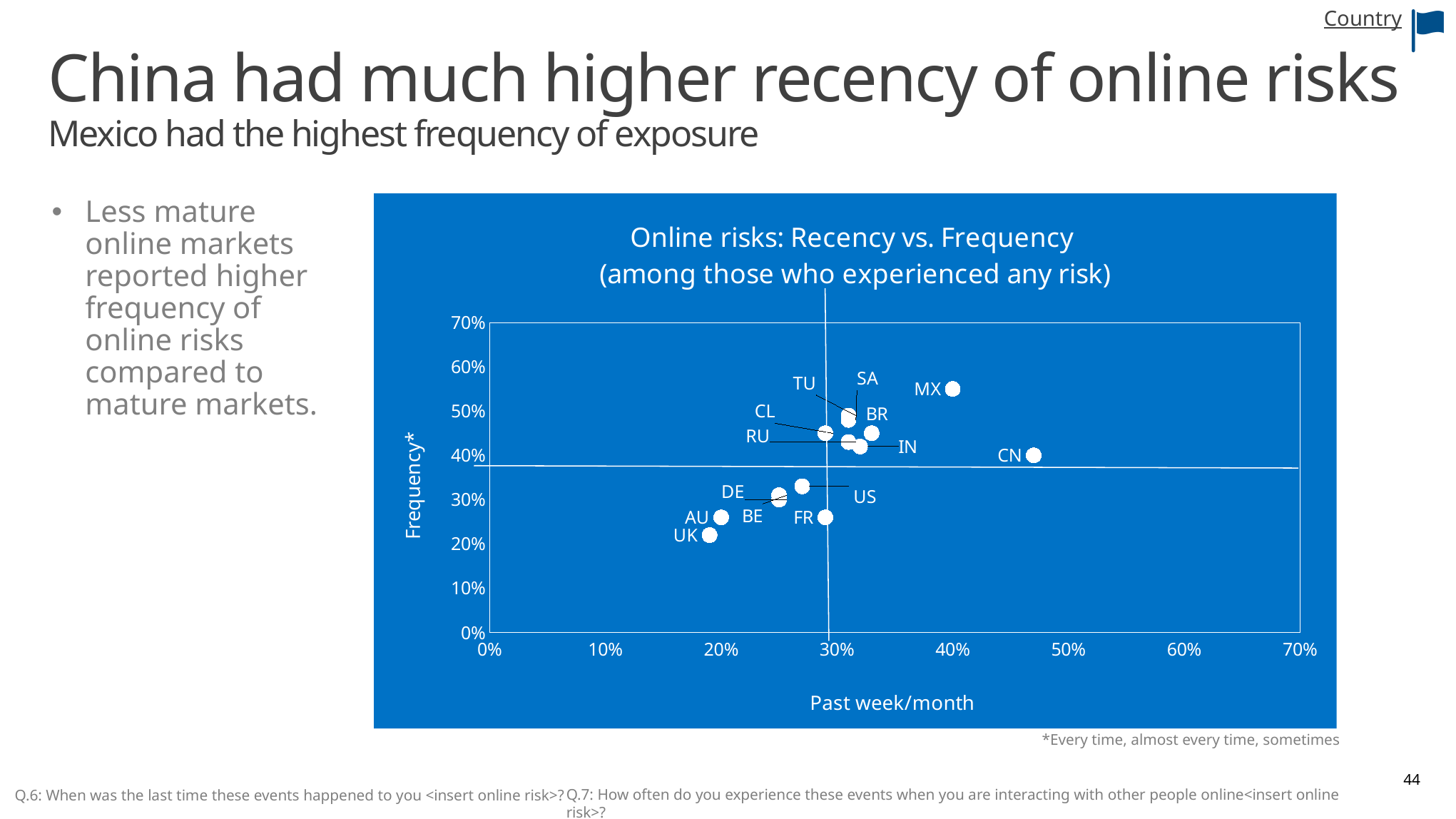
Which country has the highest frequency (vertical axis) value in the chart? MX Which country has a higher past week/month value, CN or AU? CN What is the label of the vertical axis of the chart? Frequency* Is the frequency value for UK greater or less than 30%? less Which country has the highest past week/month (horizontal axis) value in the chart? CN What is the title of the chart? Online risks: Recency vs. Frequency (among those who experienced any risk) Is the frequency value for CN greater or less than 30%? greater Which country has a higher frequency value, MX or US? MX Is the past week/month value for MX greater or less than 50%? less What kind of chart is shown on the slide? Scatter chart Which country has the lowest past week/month (horizontal axis) value in the chart? UK Which country has the lowest frequency (vertical axis) value in the chart? UK